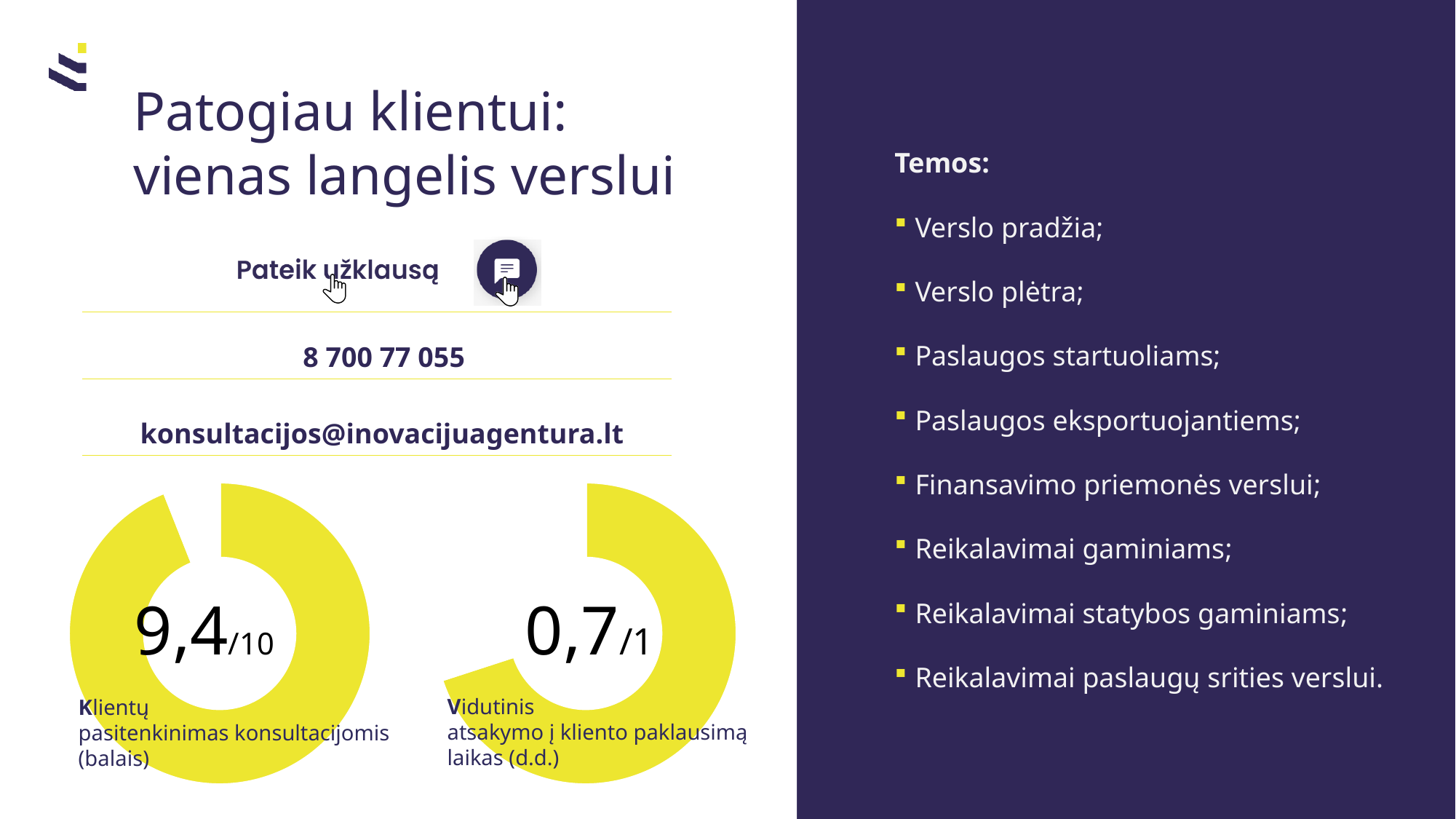
What value is shown in the centre of the left donut chart (Klientų pasitenkinimas konsultacijomis)? 9,4/10 Is the customer satisfaction score shown in the left chart greater or less than 9? greater What kind of chart is used to show the customer satisfaction score of 9,4/10? Donut chart In what unit is the value of the left chart (Klientų pasitenkinimas konsultacijomis) expressed, according to its label? balais How many donut charts are shown on the slide? 2 What is the maximum score on the scale of the left chart showing customer satisfaction with consultations? 10 In what unit is the value of the right chart (Vidutinis atsakymo į kliento paklausimą laikas) expressed, according to its label? d.d. Is the average response time shown in the right chart greater or less than 1? less What kind of chart is used to show the average response time of 0,7/1? Donut chart What value is shown in the centre of the right donut chart (Vidutinis atsakymo į kliento paklausimą laikas)? 0,7/1 What is the maximum value on the scale of the right chart showing average response time? 1